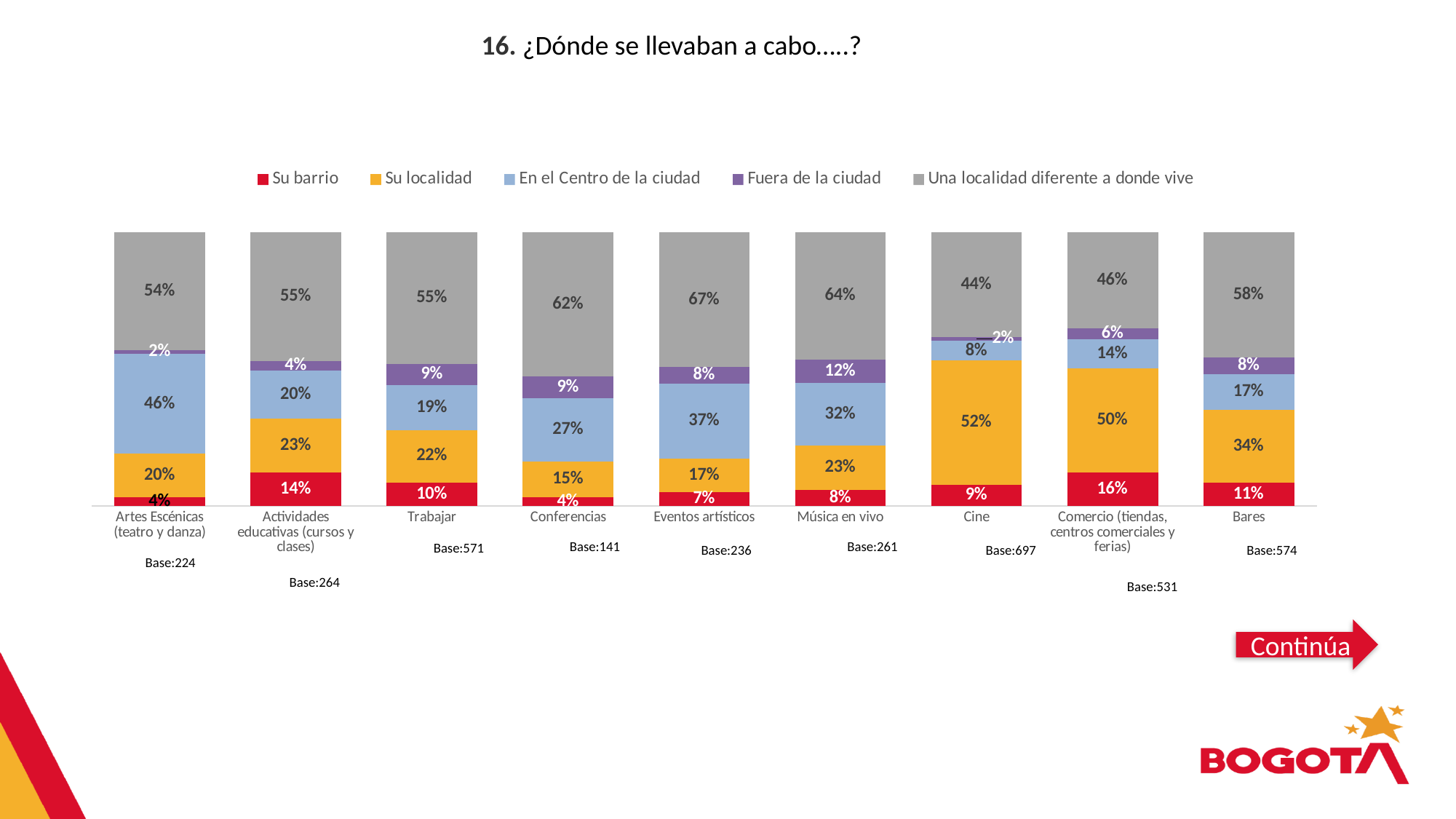
Which category has the lowest value for 'Una localidad diferente a donde vive'? Cine What is the value for 'En el Centro de la ciudad' in the Eventos artísticos category? 37% How many categories are shown on the x axis of the chart? 9 What is the difference between the 'Su localidad' values for Comercio (tiendas, centros comerciales y ferias) and Bares? 16 percentage points What kind of chart is shown on the slide? Stacked bar chart Which category has the highest value for 'Una localidad diferente a donde vive'? Eventos artísticos What base is shown for the Cine category? Base:697 How many series does the legend list? 5 Which category has the highest value for 'Su barrio'? Comercio (tiendas, centros comerciales y ferias) What is the value for 'Su localidad' in the Cine category? 52% What is the value for 'Fuera de la ciudad' in the Música en vivo category? 12% Which has a larger 'En el Centro de la ciudad' value: Artes Escénicas (teatro y danza) or Música en vivo? Artes Escénicas (teatro y danza)